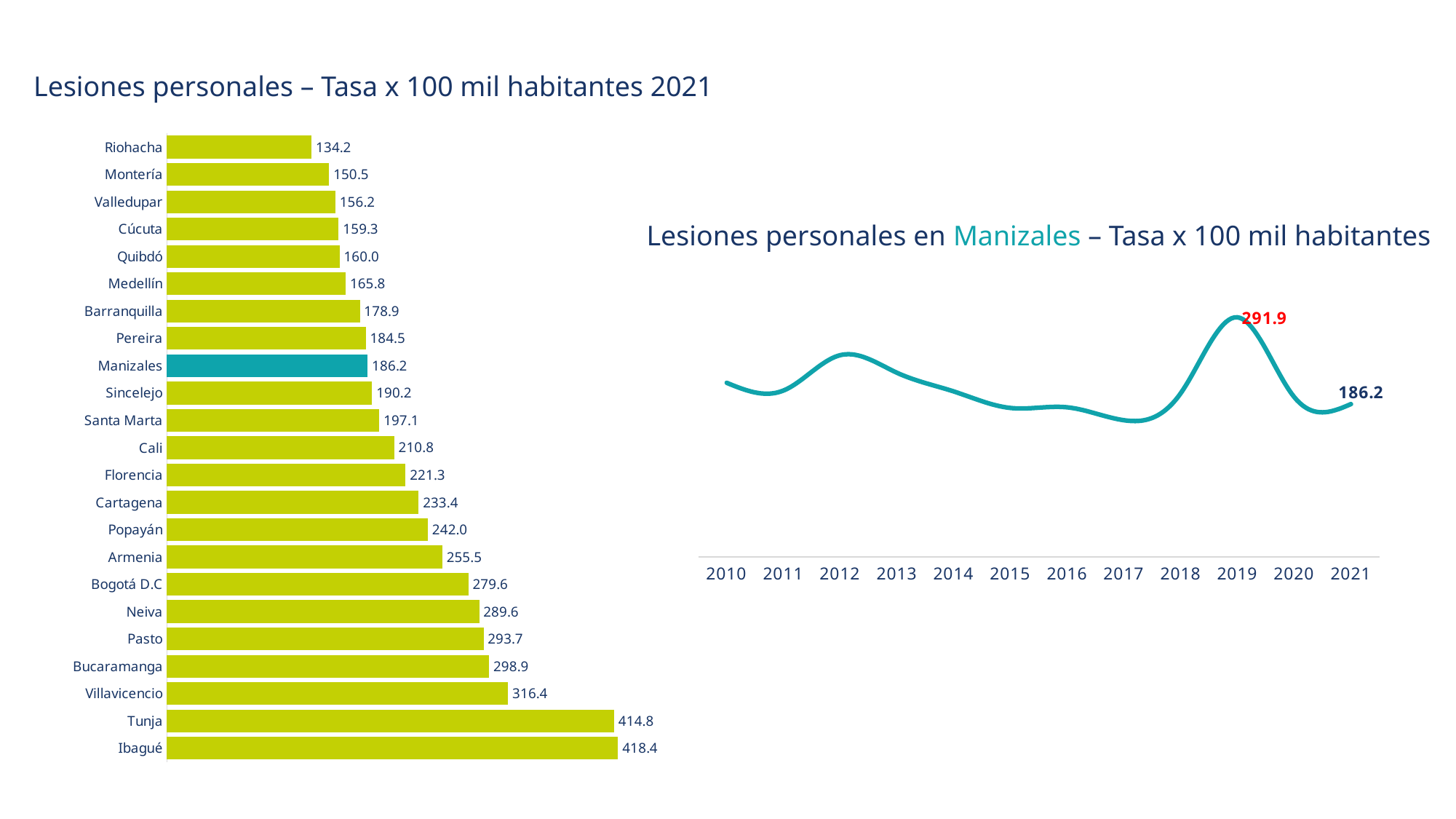
In the bar chart on the left, which city has the highest value? Ibagué In the line chart on the right, does the value rise or fall from 2019 to 2021? Fall How many cities are shown in the bar chart on the left? 23 In the bar chart on the left, what is the value for Manizales? 186.2 In the bar chart on the left, which has a larger value, Cali or Pereira? Cali In the bar chart on the left, what is the difference between the values for Ibagué and Riohacha? 284.2 In the line chart on the right, what is the value labelled for 2019? 291.9 In the bar chart on the left, which bar is highlighted in a different colour from the others? Manizales In the line chart on the right, what is the difference between the 2019 value and the 2021 value? 105.7 In the bar chart on the left, which city has the lowest value? Riohacha In the bar chart on the left, what is the value for Bogotá D.C? 279.6 What kind of chart is the chart on the left? Bar chart